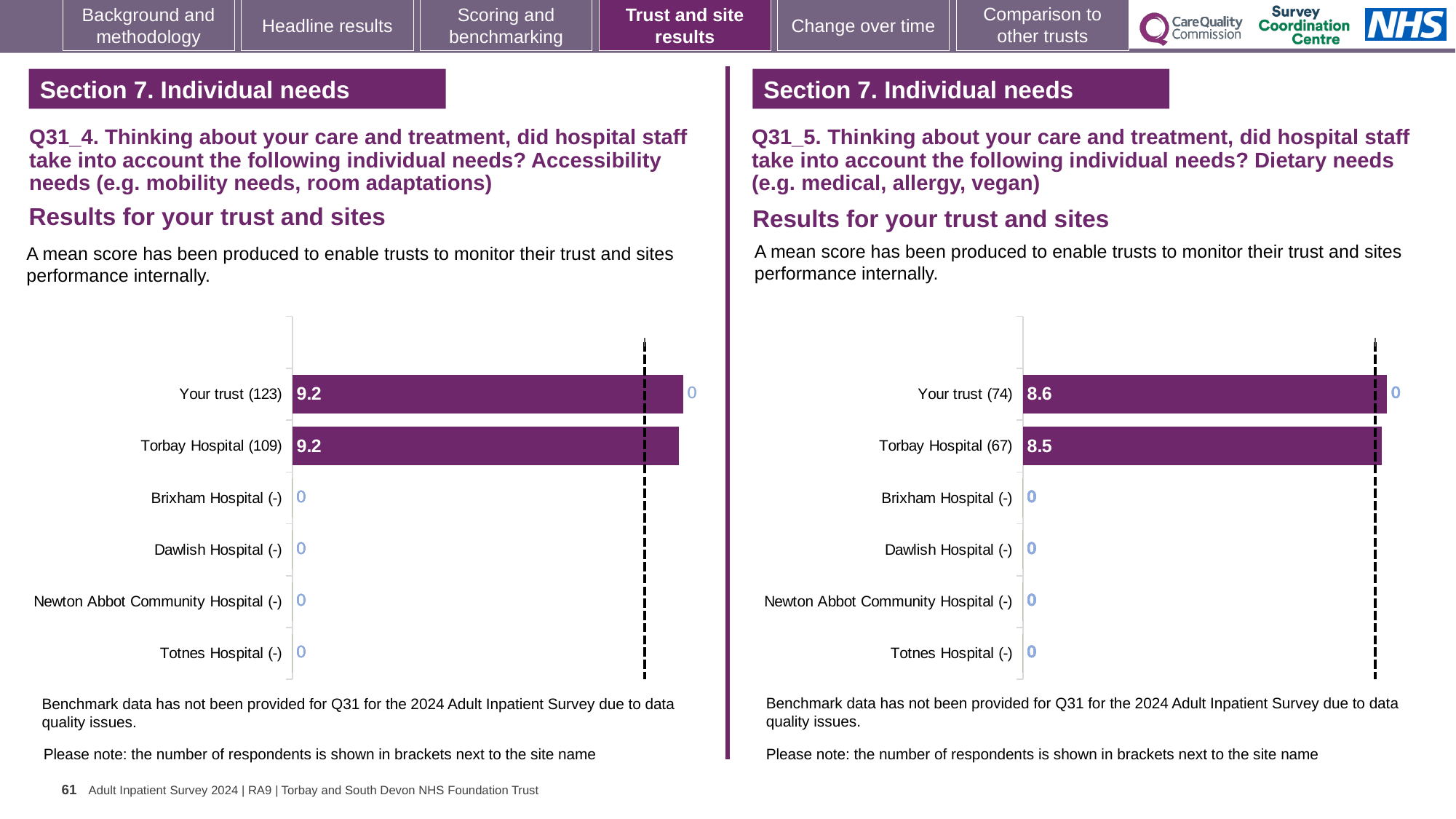
Which chart shows a higher score for Your trust: the left chart (Q31_4, Accessibility needs) or the right chart (Q31_5, Dietary needs)? The left chart (Q31_4, Accessibility needs) On the left chart (Q31_4, Accessibility needs), what is the mean score for Your trust (123)? 9.2 On the right chart (Q31_5, Dietary needs), what is the mean score for Torbay Hospital (67)? 8.5 On the right chart (Q31_5, Dietary needs), what is the difference between the scores for Your trust (74) and Torbay Hospital (67)? 0.1 On the left chart (Q31_4, Accessibility needs), how many respondents are shown in brackets for Torbay Hospital? 109 On the left chart (Q31_4, Accessibility needs), what is the difference between the scores for Your trust (123) and Torbay Hospital (109)? 0 How many site categories are listed on the left chart (Q31_4, Accessibility needs)? 6 On the right chart (Q31_5, Dietary needs), how many respondents are shown in brackets for Your trust? 74 What type of chart is used on the right (Q31_5, Dietary needs)? Bar chart On the left chart (Q31_4, Accessibility needs), which sites have a plotted bar with a score shown? Your trust (123) and Torbay Hospital (109) On the left chart (Q31_4, Accessibility needs), what is the mean score for Torbay Hospital (109)? 9.2 On the right chart (Q31_5, Dietary needs), what is the mean score for Your trust (74)? 8.6